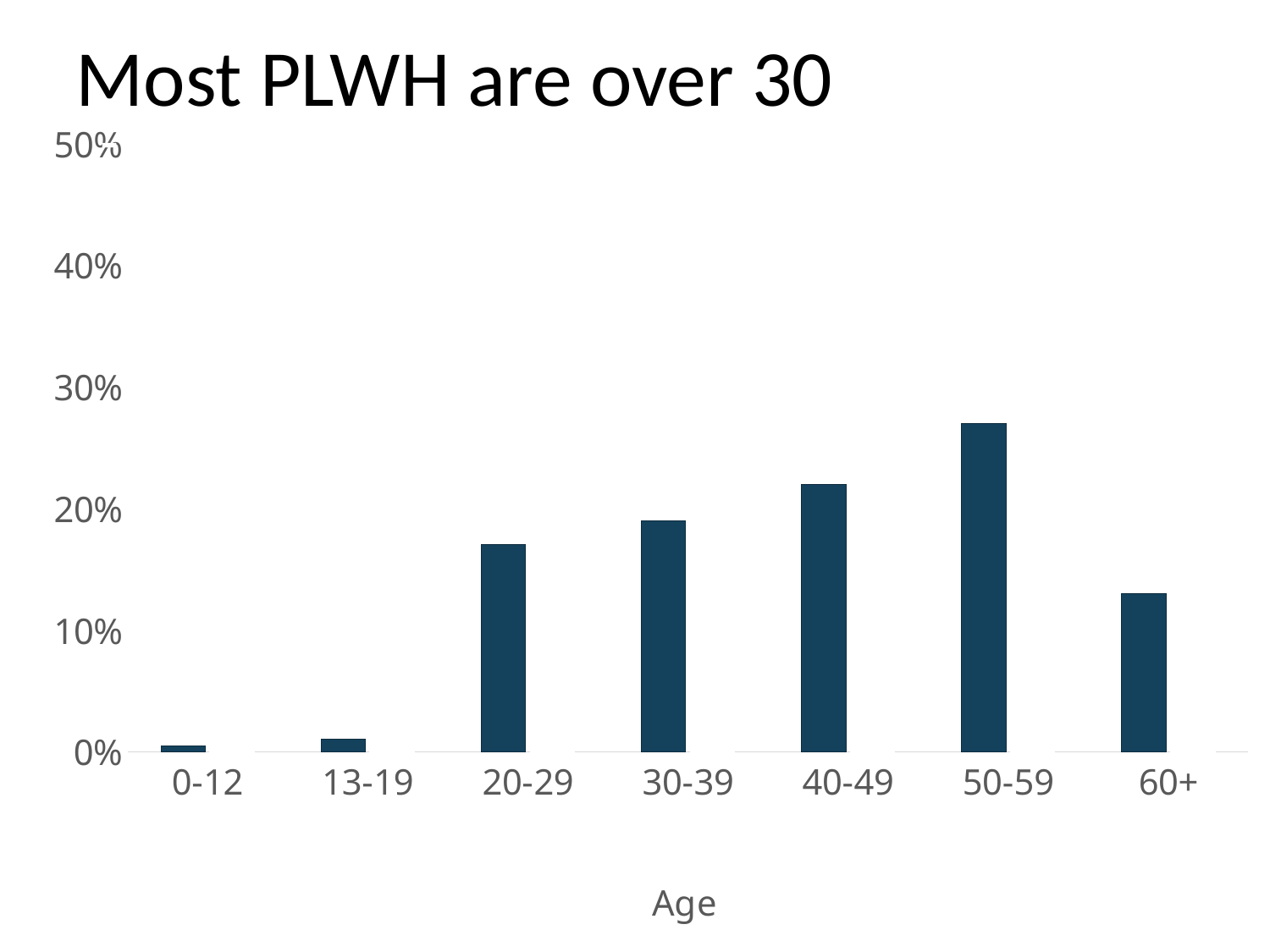
Which is larger, the value for 20-29 or the value for 30-39? 30-39 Is the value for 50-59 greater or less than 20%? greater Which age group has the lowest value? 0-12 Is the value for 60+ greater or less than 20%? less How many age categories are shown on the x axis? 7 Do the values rise or fall from the 0-12 group to the 50-59 group? rise Which age group has the highest value? 50-59 What kind of chart is shown on the slide? bar chart Which is larger, the value for 40-49 or the value for 60+? 40-49 What is the title of the chart? Most PLWH are over 30 Is the value for 13-19 greater or less than 10%? less What is the label of the x axis? Age